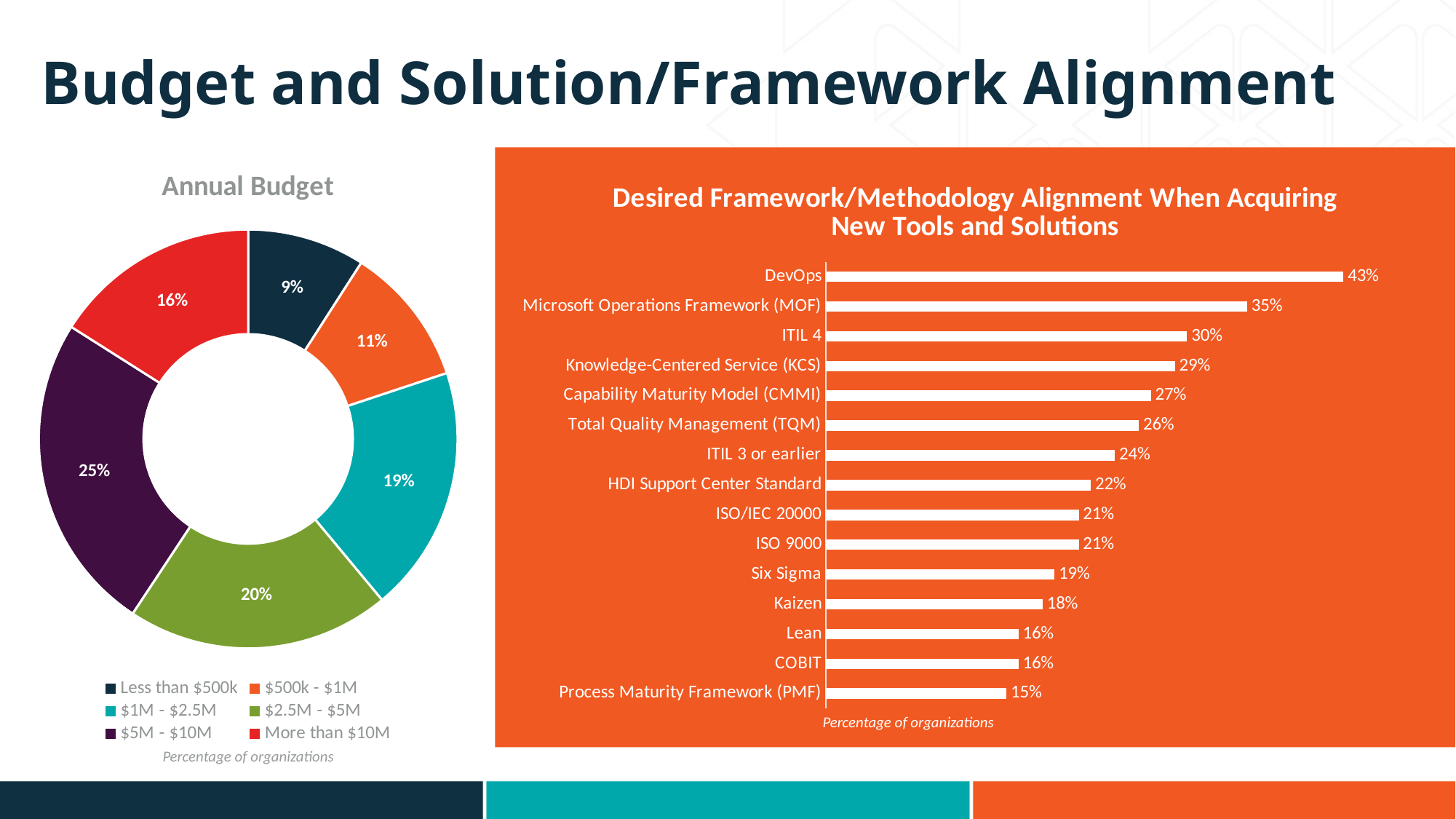
In the Desired Framework/Methodology Alignment chart, which is larger: ITIL 4 or ITIL 3 or earlier? ITIL 4 What kind of chart is the Desired Framework/Methodology Alignment chart? Bar chart In the Annual Budget chart, what percentage of organizations have a budget of $5M - $10M? 25% In the Desired Framework/Methodology Alignment chart, which framework has the lowest value? Process Maturity Framework (PMF) In the Annual Budget chart, which budget category has the largest share? $5M - $10M In the Desired Framework/Methodology Alignment chart, what is the difference between DevOps and Microsoft Operations Framework (MOF)? 8% In the Annual Budget chart, which budget category has the smallest share? Less than $500k In the Annual Budget chart, how many budget categories are shown? 6 In the Desired Framework/Methodology Alignment chart, what is the value for DevOps? 43% In the Annual Budget chart, what is the difference between the $2.5M - $5M share and the $500k - $1M share? 9% In the Desired Framework/Methodology Alignment chart, how many frameworks are listed? 15 What kind of chart is the Annual Budget chart? Doughnut chart